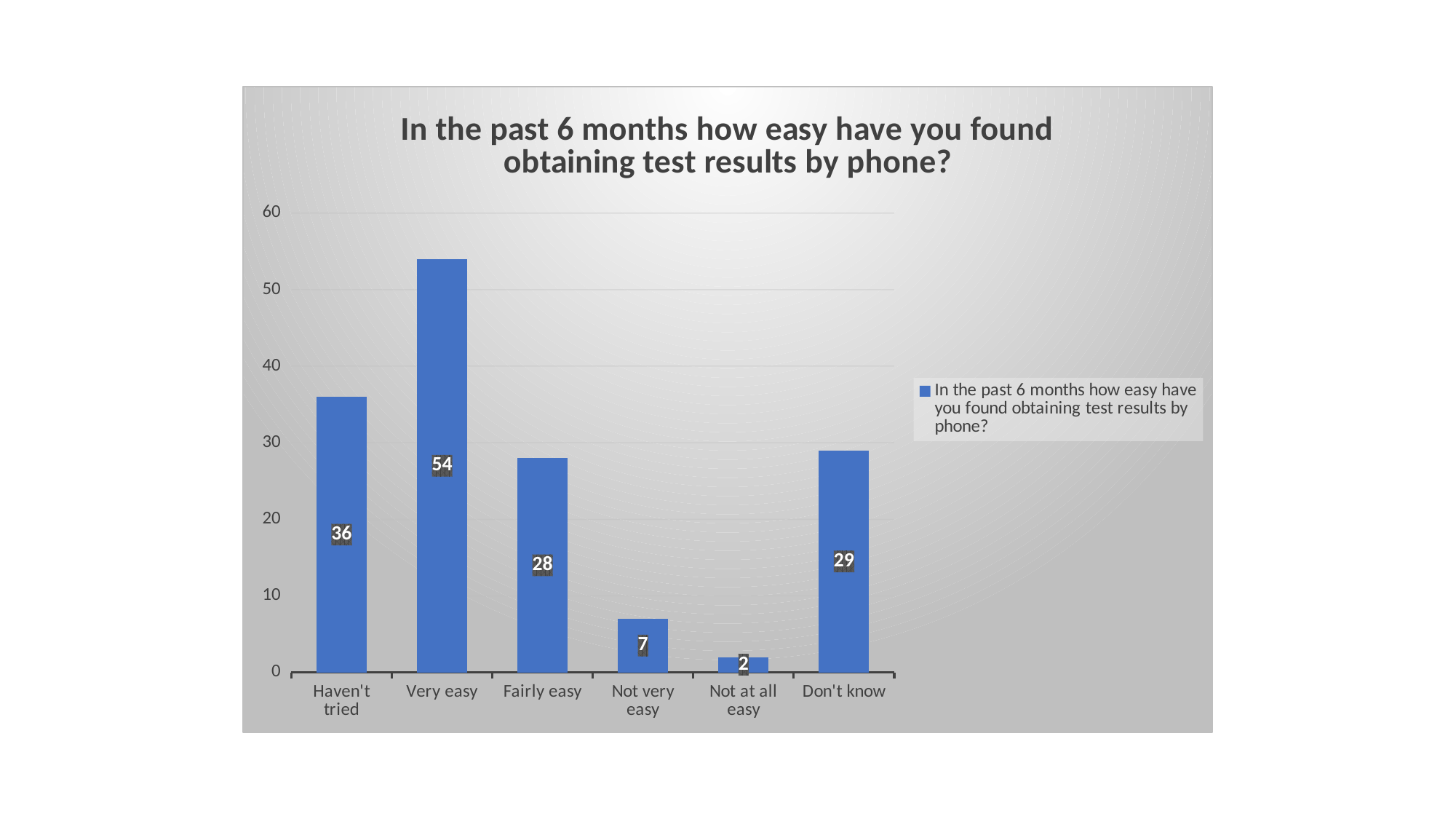
What is the value for "Very easy"? 54 Which is larger, the value for "Haven't tried" or the value for "Don't know"? Haven't tried How many series does the legend list? 1 What is the title of the chart? In the past 6 months how easy have you found obtaining test results by phone? Which category has the lowest value? Not at all easy What is the difference between the values for "Very easy" and "Fairly easy"? 26 How many categories are shown on the x axis? 6 Is the value for "Very easy" greater or less than 50? greater What is the value for "Not at all easy"? 2 What is the value for "Haven't tried"? 36 Which category has the highest value? Very easy What kind of chart is shown on the slide? bar chart